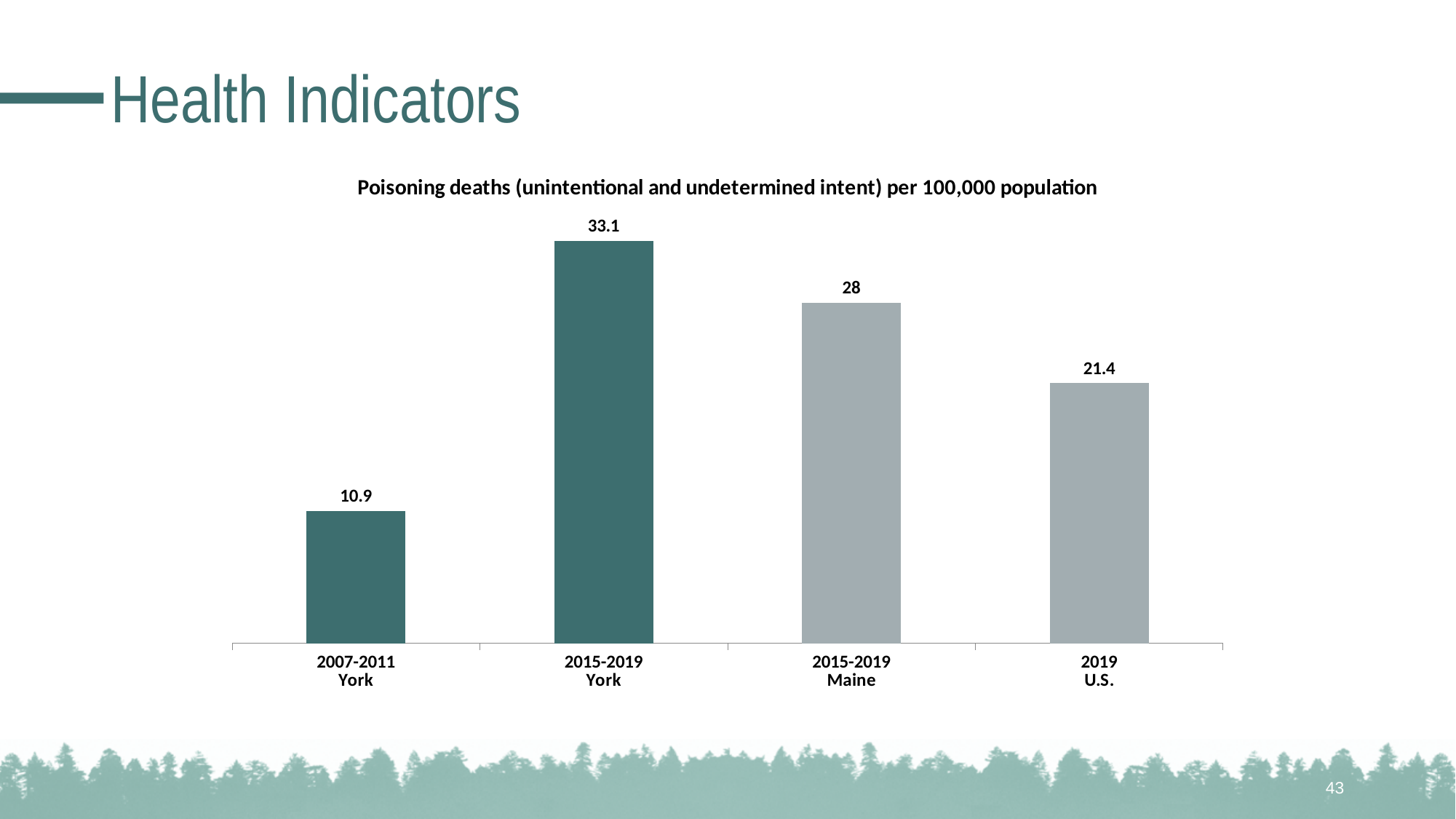
Which is larger, the York 2015-2019 rate or the Maine 2015-2019 rate? York 2015-2019 What is the difference between the Maine 2015-2019 rate and the U.S. 2019 rate? 6.6 What is the poisoning death rate per 100,000 population for York in 2007-2011? 10.9 What is the poisoning death rate per 100,000 population for the U.S. in 2019? 21.4 What kind of chart is shown on the slide? Bar chart What is the poisoning death rate per 100,000 population for Maine in 2015-2019? 28 Which category has the lowest poisoning death rate? 2007-2011 York What is the difference between the York 2015-2019 rate and the York 2007-2011 rate? 22.2 What is the title of the chart? Poisoning deaths (unintentional and undetermined intent) per 100,000 population How many bars are shown in the chart? 4 Which category has the highest poisoning death rate? 2015-2019 York What is the poisoning death rate per 100,000 population for York in 2015-2019? 33.1